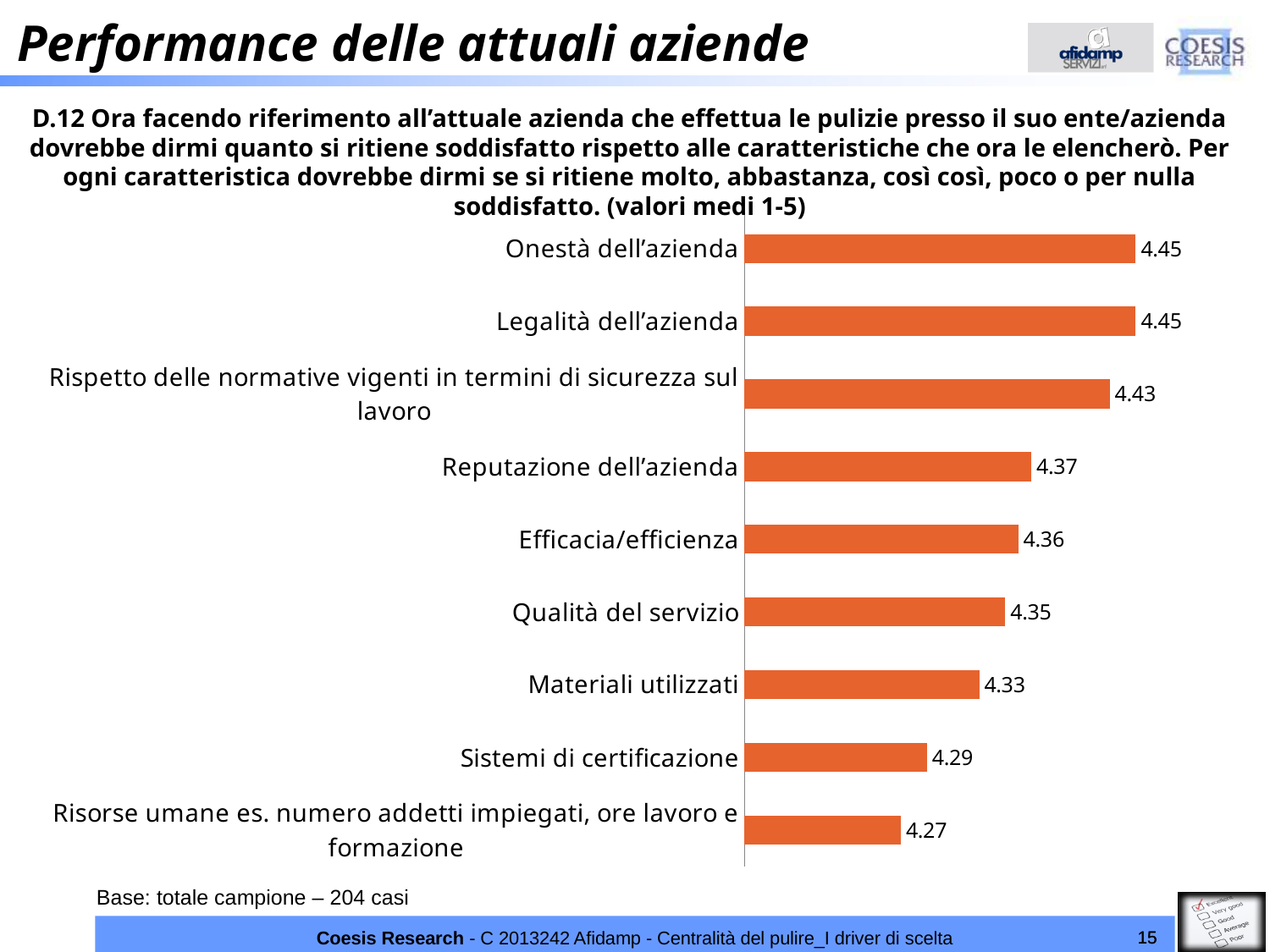
What colour are the bars in the chart? Orange Which category has the lowest value? Risorse umane es. numero addetti impiegati, ore lavoro e formazione What kind of chart is shown on the slide? Bar chart What is the value for Reputazione dell'azienda? 4.37 What is the difference between the value for Reputazione dell'azienda and the value for Sistemi di certificazione? 0.08 What is the difference between the value for Legalità dell'azienda and the value for Risorse umane es. numero addetti impiegati, ore lavoro e formazione? 0.18 What is the value for Onestà dell'azienda? 4.45 What is the highest value shown in the chart? 4.45 What is the value for Sistemi di certificazione? 4.29 Which is larger, the value for Qualità del servizio or the value for Sistemi di certificazione? Qualità del servizio What is the value for Materiali utilizzati? 4.33 How many categories are shown in the chart? 9